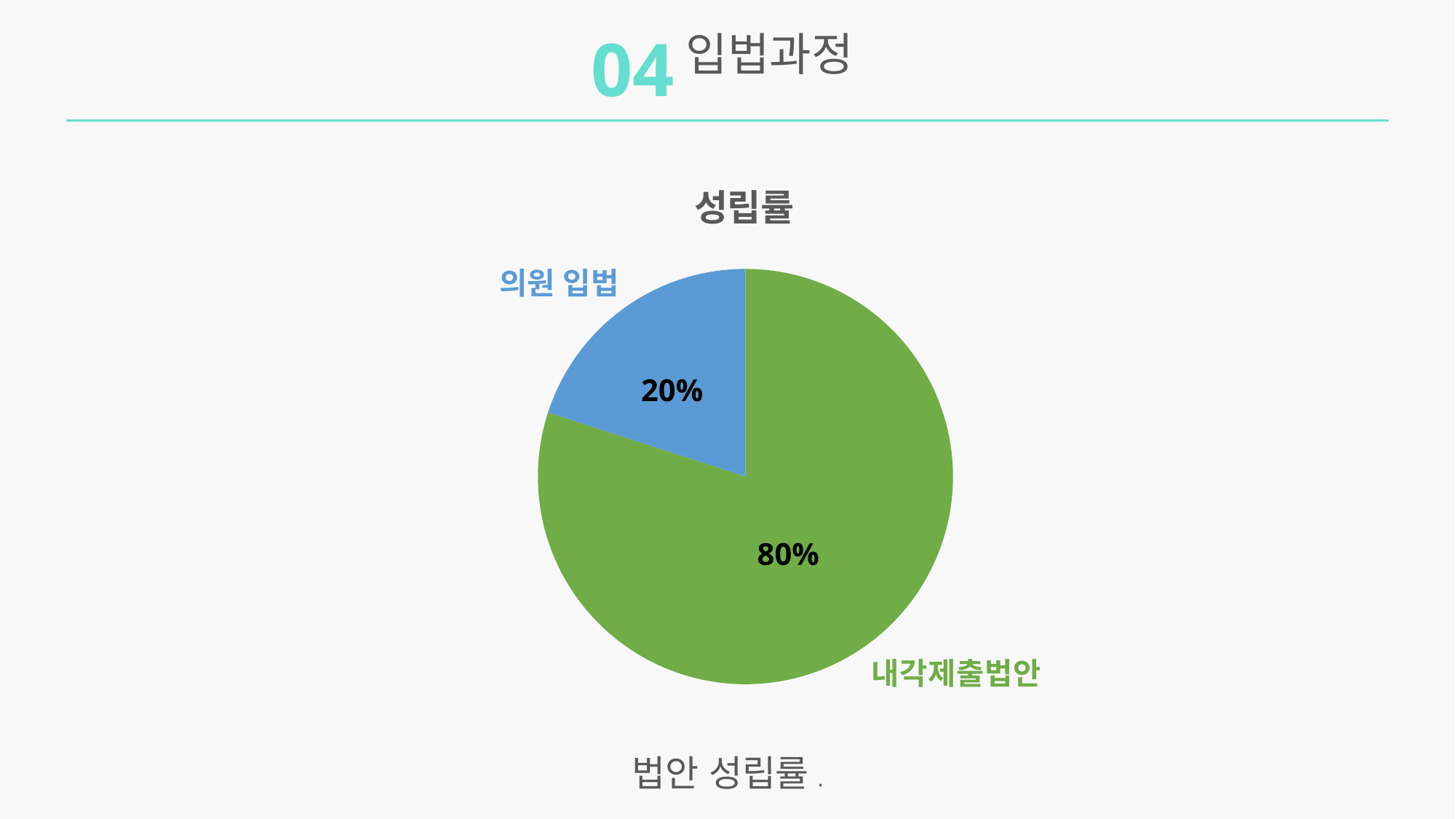
What kind of chart is shown on the slide? pie chart What is the difference between the values for 내각제출법안 and 의원 입법? 60% What colour is the slice for 내각제출법안? green How many slices does the pie chart have? 2 What share of the pie does 의원 입법 represent? 20% Which category has the largest slice of the pie? 내각제출법안 What is the value shown for 내각제출법안? 80% What is the title of the chart? 성립률 What is the value shown for 의원 입법? 20% Which is larger, the value for 의원 입법 or the value for 내각제출법안? 내각제출법안 Which category has the smallest slice of the pie? 의원 입법